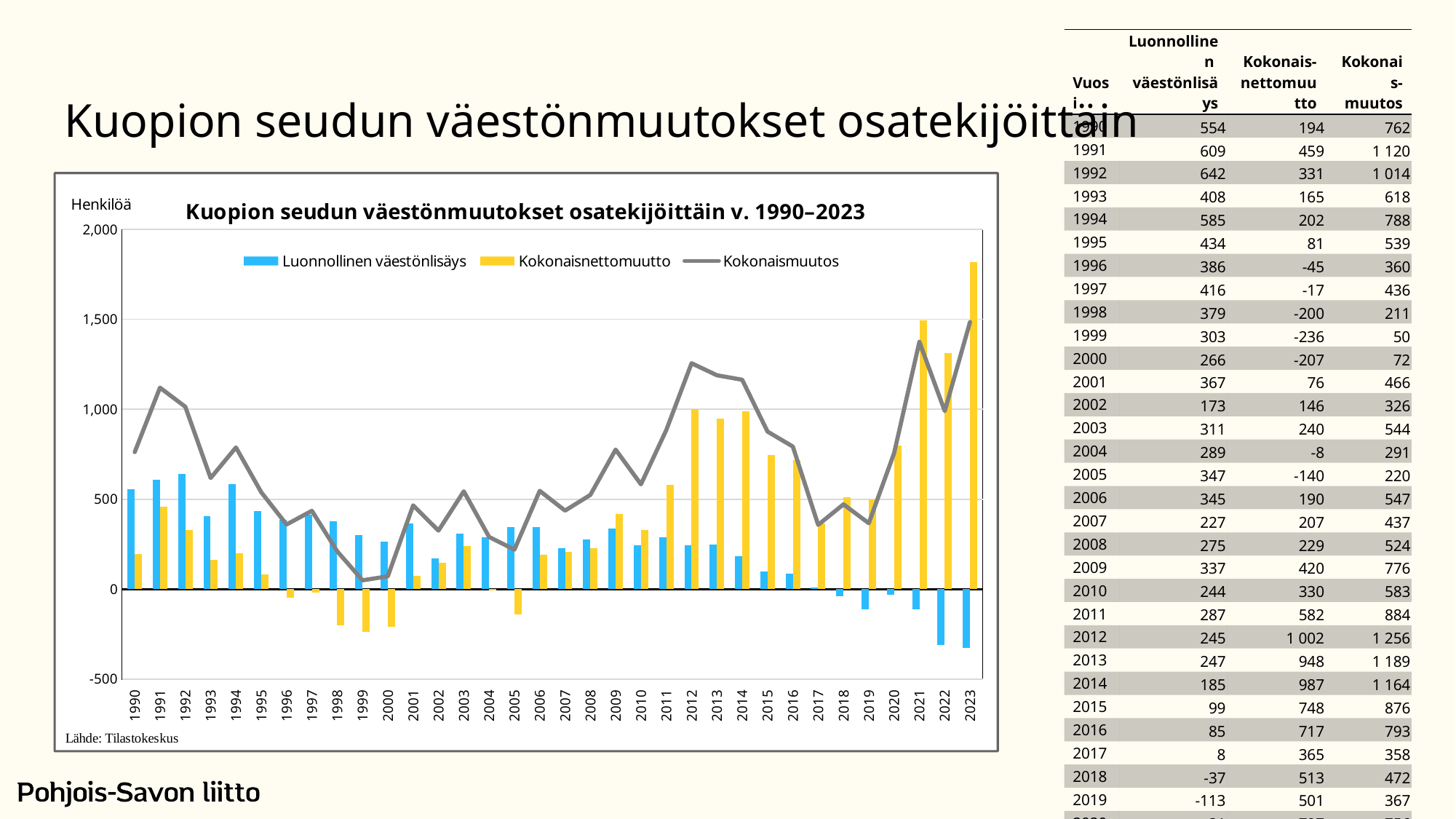
What is the Kokonaismuutos value for 2011? 884 What source is cited below the chart? Tilastokeskus In which year is Kokonaismuutos the lowest? 1999 What is the difference between Kokonaismuutos in 1991 and in 1990? 358 Is the Kokonaisnettomuutto value for 2023 greater or less than 1,500? greater How many series does the chart legend list? 3 What is the Luonnollinen väestönlisäys value for 1992? 642 What kind of chart is shown on the slide? bar and line chart How many years are plotted along the x axis of the chart? 34 Which year has the larger Luonnollinen väestönlisäys, 1992 or 1995? 1992 In which year is the Kokonaisnettomuutto bar the highest? 2023 What is the Kokonaisnettomuutto value for 2012? 1 002